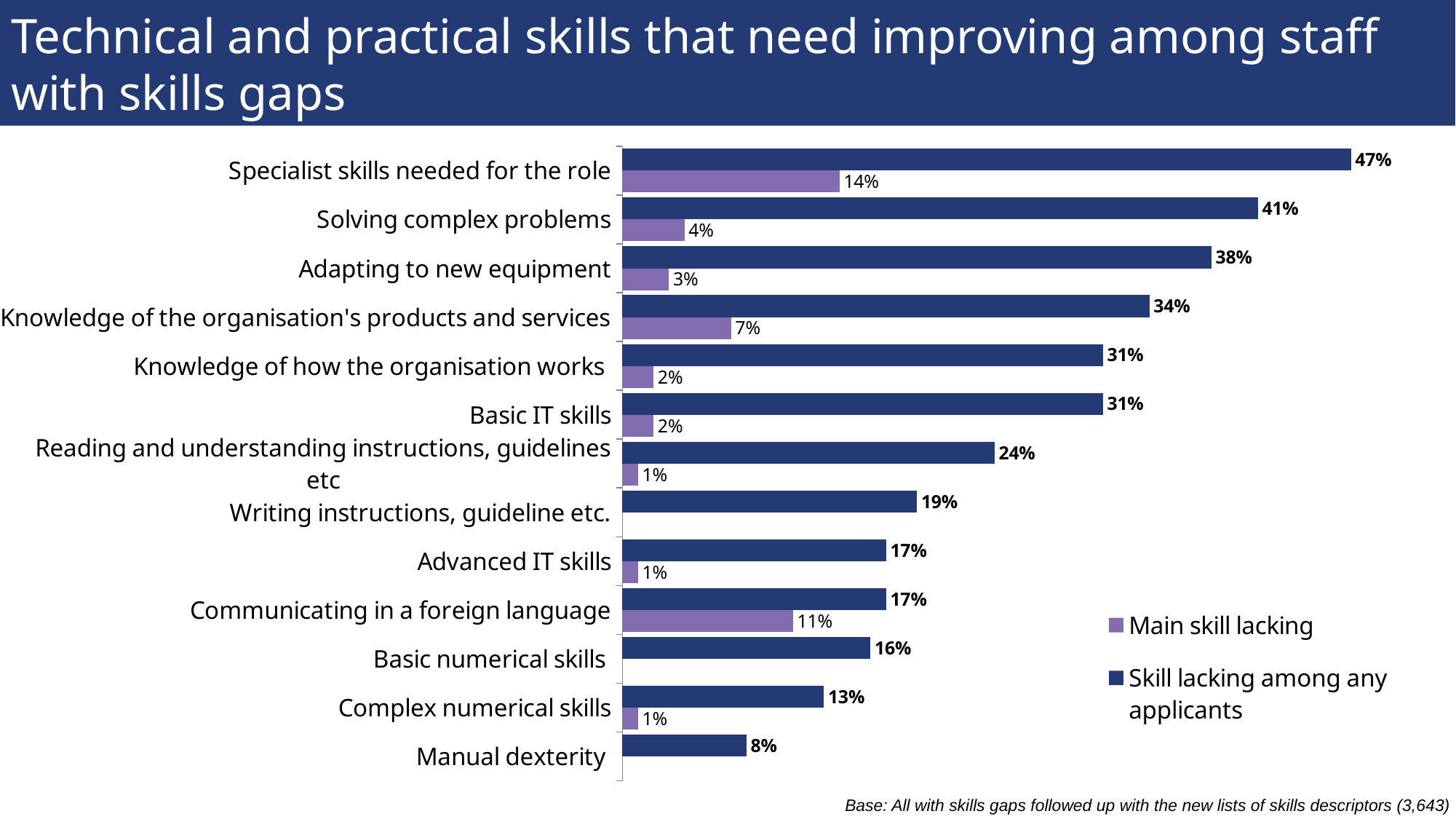
What is the value for 'Skill lacking among any applicants' for Manual dexterity? 8% Which category has the lowest value for 'Skill lacking among any applicants'? Manual dexterity How many series does the legend list? 2 Which category has the highest value for 'Skill lacking among any applicants'? Specialist skills needed for the role What is the value for 'Main skill lacking' for Knowledge of the organisation's products and services? 7% What kind of chart is shown on the slide? Bar chart Which is larger: the 'Main skill lacking' value for Specialist skills needed for the role or for Communicating in a foreign language? Specialist skills needed for the role What is the difference between the 'Skill lacking among any applicants' and 'Main skill lacking' values for Specialist skills needed for the role? 33% What is the value for 'Skill lacking among any applicants' for Specialist skills needed for the role? 47% What is the value for 'Main skill lacking' for Communicating in a foreign language? 11% What is the difference between the 'Skill lacking among any applicants' values for Solving complex problems and Adapting to new equipment? 3% How many categories are shown on the chart? 13